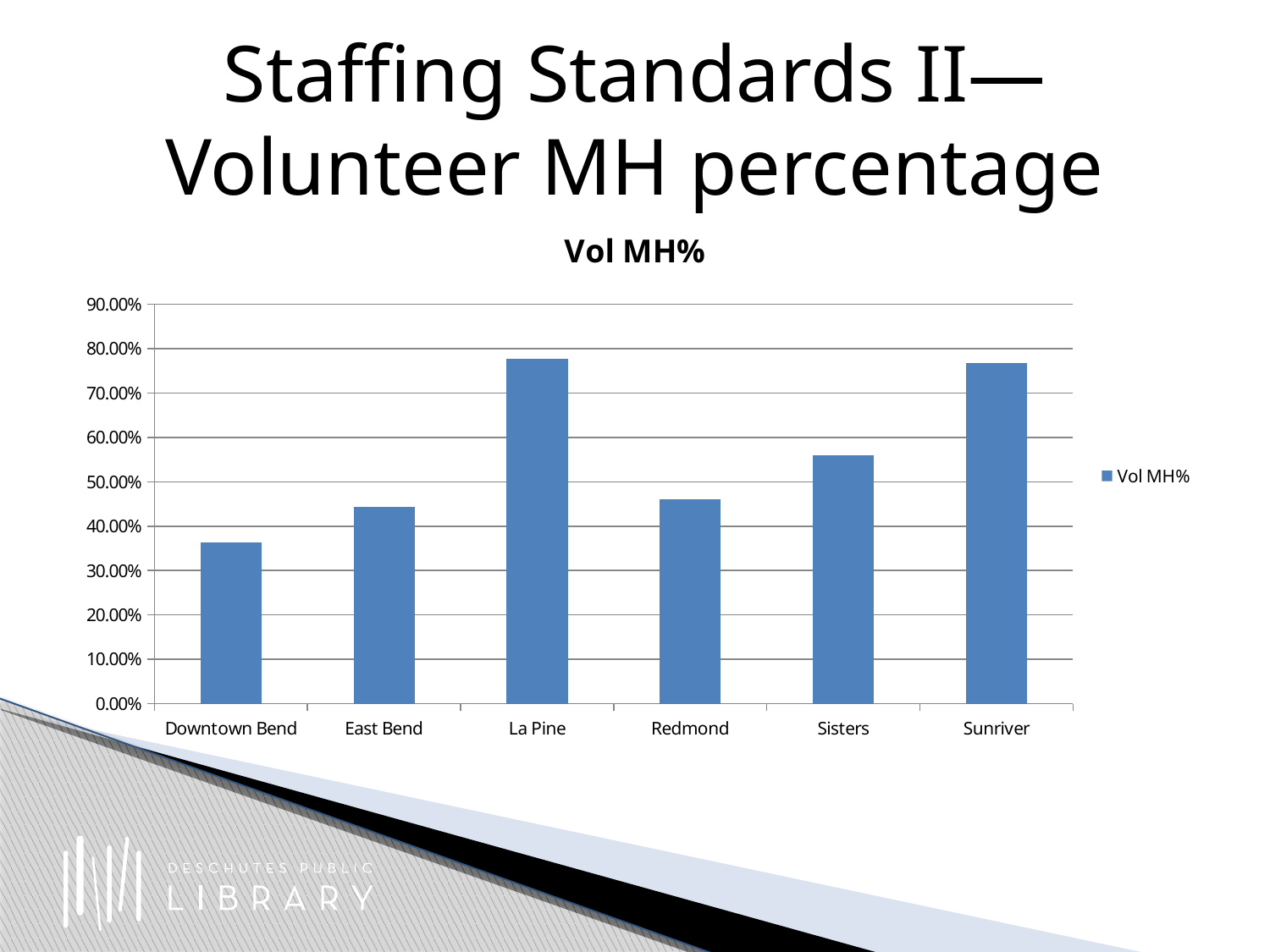
Is the Vol MH% value for Sisters greater or less than 50.00%? greater Is the Vol MH% value for Sunriver greater or less than 70.00%? greater How many library branches are shown on the x axis of the chart? 6 Is the Vol MH% value for La Pine greater or less than 70.00%? greater What type of chart is shown on the slide? bar chart Which has a higher Vol MH% value, Sisters or Redmond? Sisters What is the title of the chart? Vol MH% Which branch has the lowest Vol MH% value? Downtown Bend How many series does the chart legend list? 1 Which has a higher Vol MH% value, East Bend or Downtown Bend? East Bend